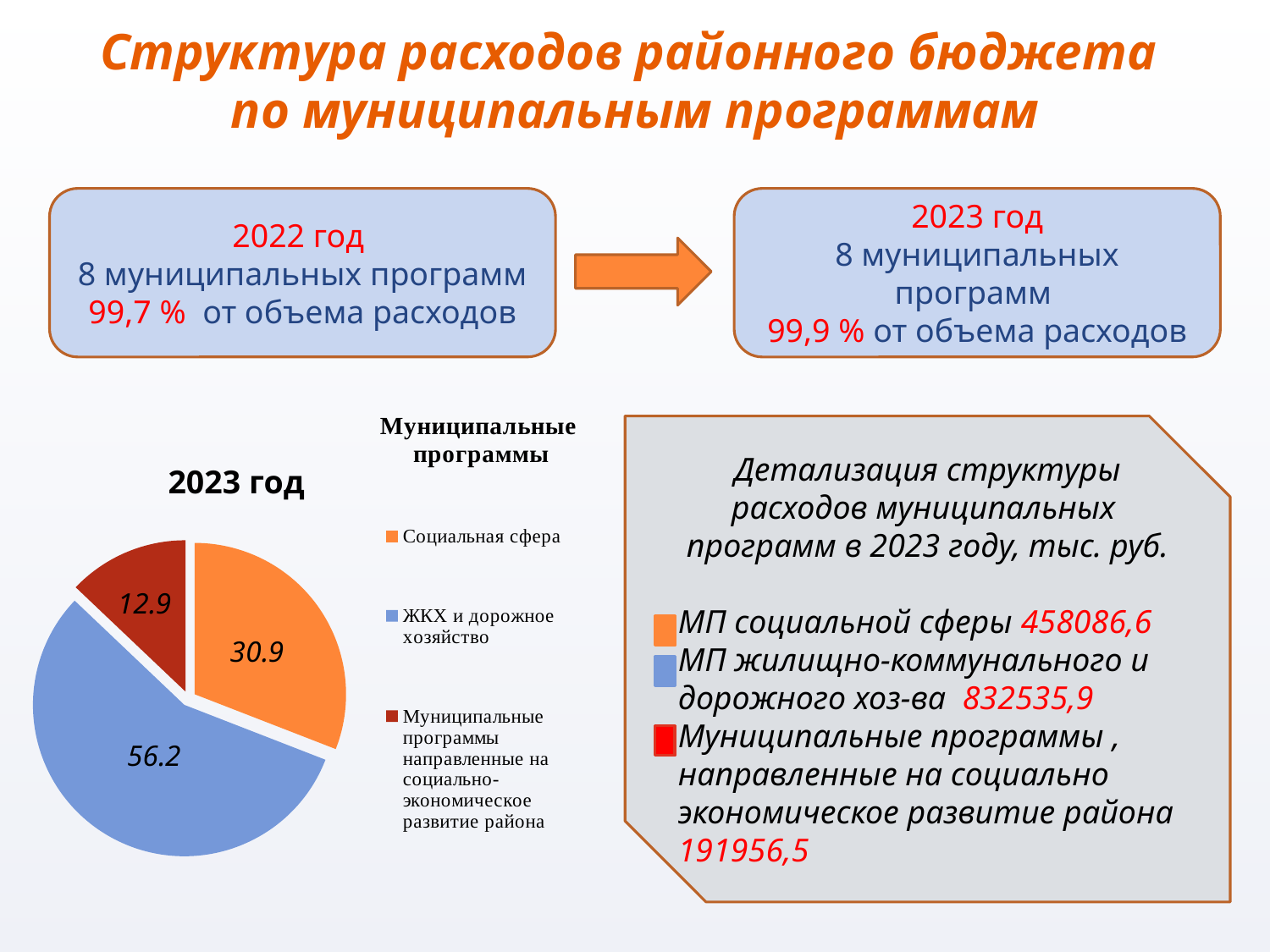
Which is larger in the pie chart: Социальная сфера or Муниципальные программы направленные на социально-экономическое развитие района? Социальная сфера What is the value shown for Социальная сфера in the pie chart? 30.9 What kind of chart is shown on the slide? pie chart What is the value shown for Муниципальные программы направленные на социально-экономическое развитие района in the pie chart? 12.9 How many entries does the pie chart's legend list? 3 How many slices does the pie chart have? 3 Which slice of the pie chart is the largest? ЖКХ и дорожное хозяйство What is the title of the pie chart? Муниципальные программы What colour is the slice for ЖКХ и дорожное хозяйство in the pie chart? blue Which slice of the pie chart is the smallest? Муниципальные программы направленные на социально-экономическое развитие района What is the difference between the values for ЖКХ и дорожное хозяйство and Социальная сфера in the pie chart? 25.3 What is the value shown for ЖКХ и дорожное хозяйство in the pie chart? 56.2